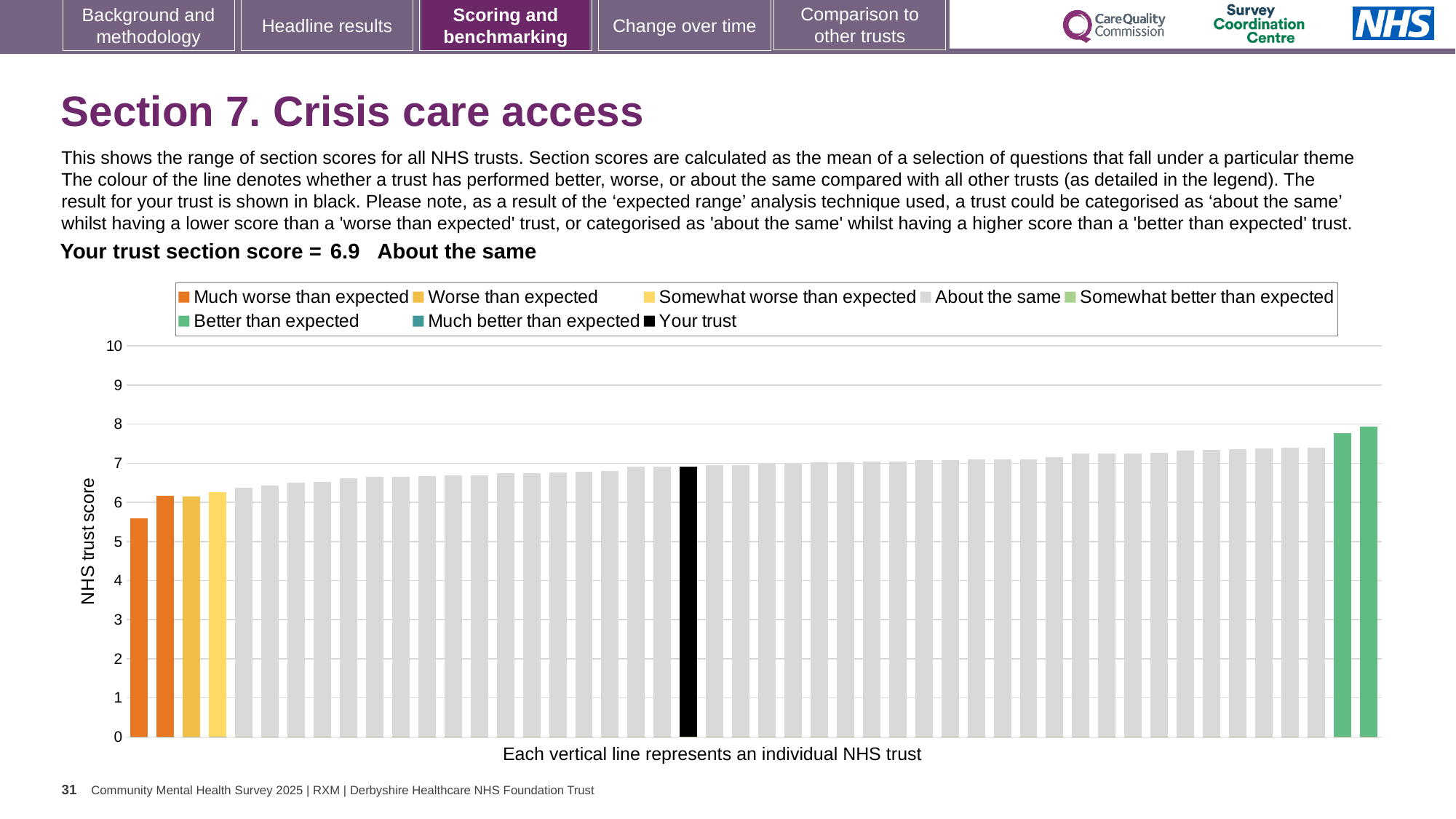
How many entries does the chart legend list? 8 Is the value of the highest bar in the chart greater or less than 7? greater Is the value of the lowest bar in the chart greater or less than 6? less Do the bar values rise or fall moving from left to right along the x axis? rise How many bars are coloured orange (Much worse than expected)? 2 How many bars are coloured green (Better than expected)? 2 Is the value of the black 'Your trust' bar greater or less than 5? greater What is the label on the vertical axis of the chart? NHS trust score Which category is your trust placed in for this section? About the same What kind of chart is shown on the slide? bar chart Which legend category does the highest bar in the chart belong to? Better than expected What is the section score for your trust shown on the slide? 6.9